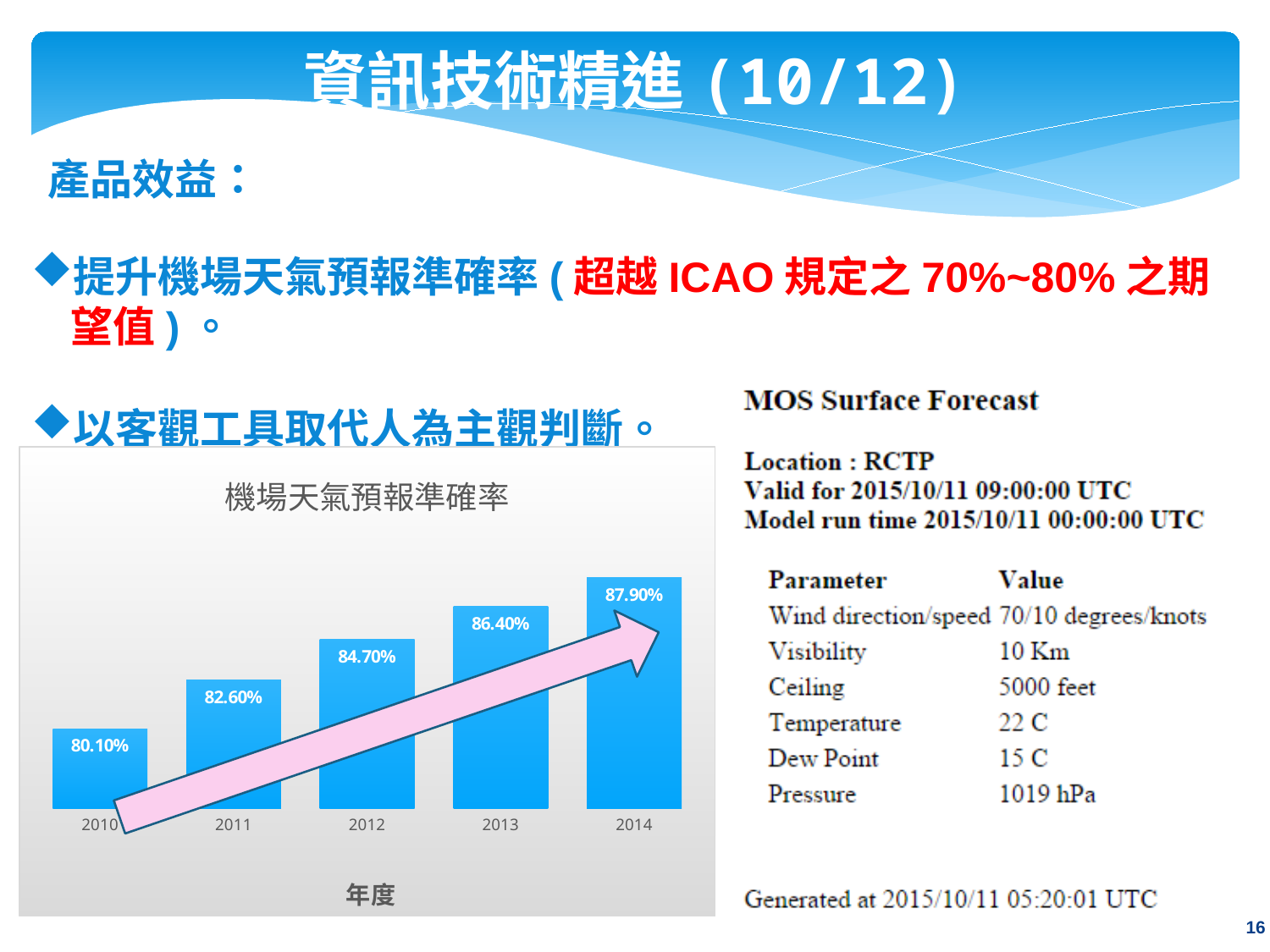
What is the value for 2010 in the 機場天氣預報準確率 chart? 80.10% What is the value for 2014 in the 機場天氣預報準確率 chart? 87.90% Which year has the lowest value in the 機場天氣預報準確率 chart? 2010 How many years are shown in the 機場天氣預報準確率 chart? 5 Do the values in the 機場天氣預報準確率 chart rise or fall from 2010 to 2014? rise What is the difference between the 2013 and 2012 values in the 機場天氣預報準確率 chart? 1.70% What is the value for 2012 in the 機場天氣預報準確率 chart? 84.70% What kind of chart is the 機場天氣預報準確率 chart? bar chart What is the x-axis title of the 機場天氣預報準確率 chart? 年度 What is the difference between the 2014 and 2010 values in the 機場天氣預報準確率 chart? 7.80% Which is larger in the 機場天氣預報準確率 chart, the value for 2011 or the value for 2013? 2013 Which year has the highest value in the 機場天氣預報準確率 chart? 2014